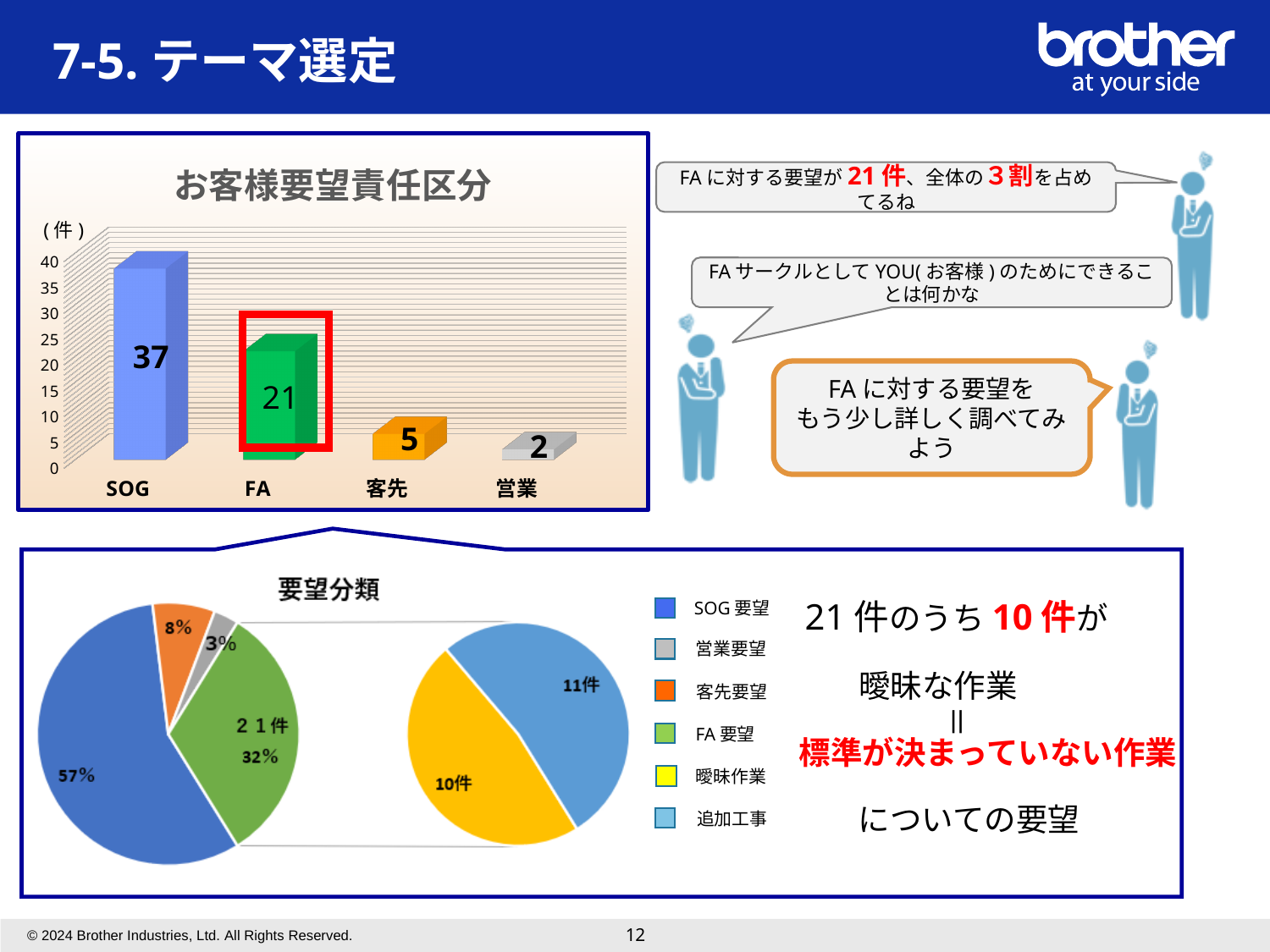
In the bar chart お客様要望責任区分, what is the difference between the values for SOG and FA? 16 In the smaller pie chart on the right of 要望分類, what is the value for 曖昧作業? 10件 In the pie chart 要望分類, what share does the FA 要望 slice have? 32% In the pie chart 要望分類, what share does the SOG 要望 slice have? 57% What kind of chart is お客様要望責任区分? bar chart In the bar chart お客様要望責任区分, how many categories are shown on the x axis? 4 In the bar chart お客様要望責任区分, which category has the highest value? SOG In the bar chart お客様要望責任区分, what is the value for 客先? 5 In the bar chart お客様要望責任区分, what is the value for FA? 21 In the pie chart 要望分類, which is larger, the 客先要望 slice or the 営業要望 slice? 客先要望 In the bar chart お客様要望責任区分, which category has the lowest value? 営業 In the bar chart お客様要望責任区分, what is the value for SOG? 37